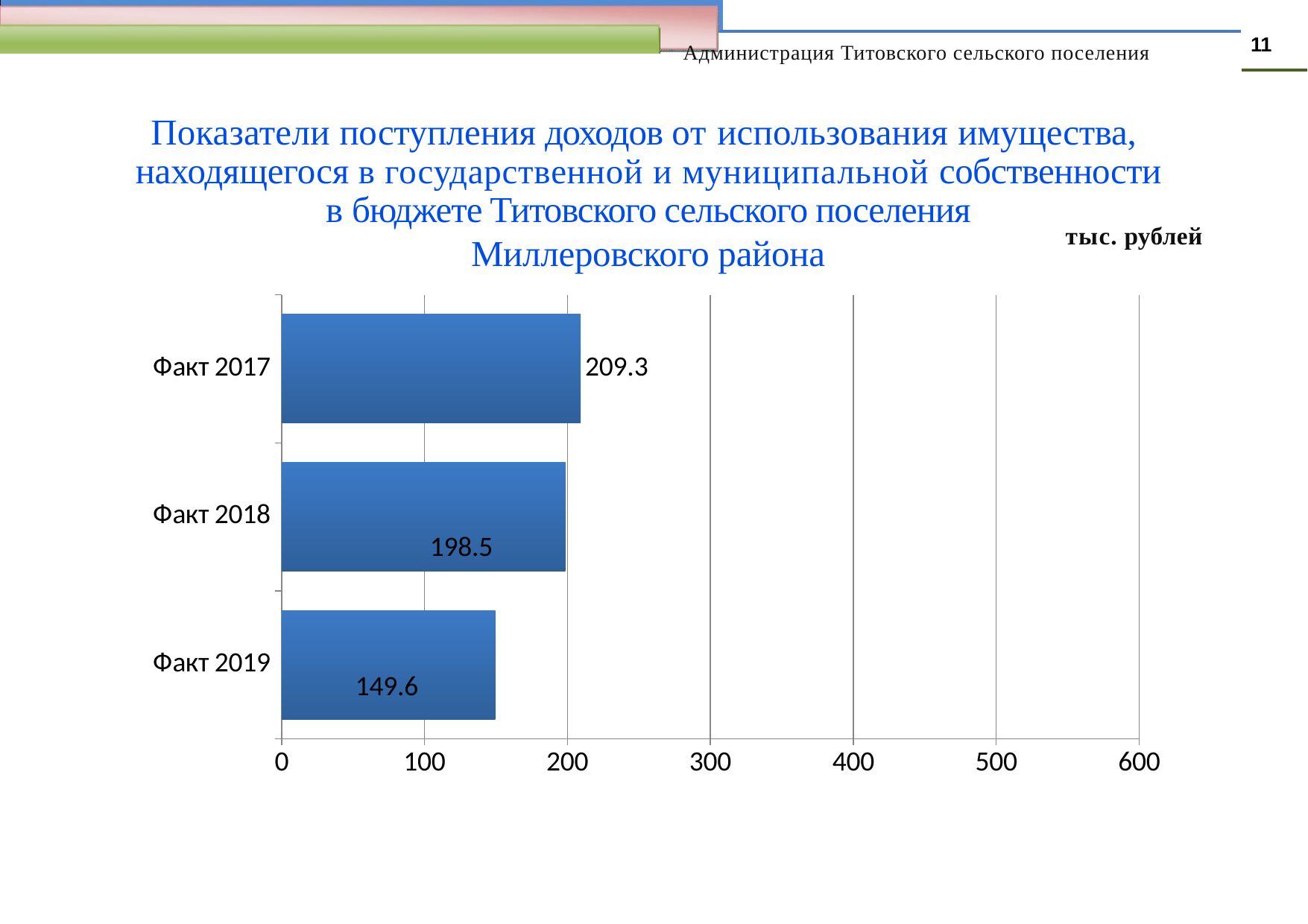
What is the value for Факт 2017? 209.3 What is the value for Факт 2018? 198.5 Which is larger, the value for Факт 2018 or the value for Факт 2019? Факт 2018 What unit of measurement is indicated for the chart values? тыс. рублей What kind of chart is shown on the slide? bar chart What is the difference between the values for Факт 2018 and Факт 2019? 48.9 How many categories are shown in the chart? 3 Which category has the highest value? Факт 2017 What is the difference between the values for Факт 2017 and Факт 2019? 59.7 Is the value for Факт 2019 greater or less than 200? less Which category has the lowest value? Факт 2019 What is the value for Факт 2019? 149.6